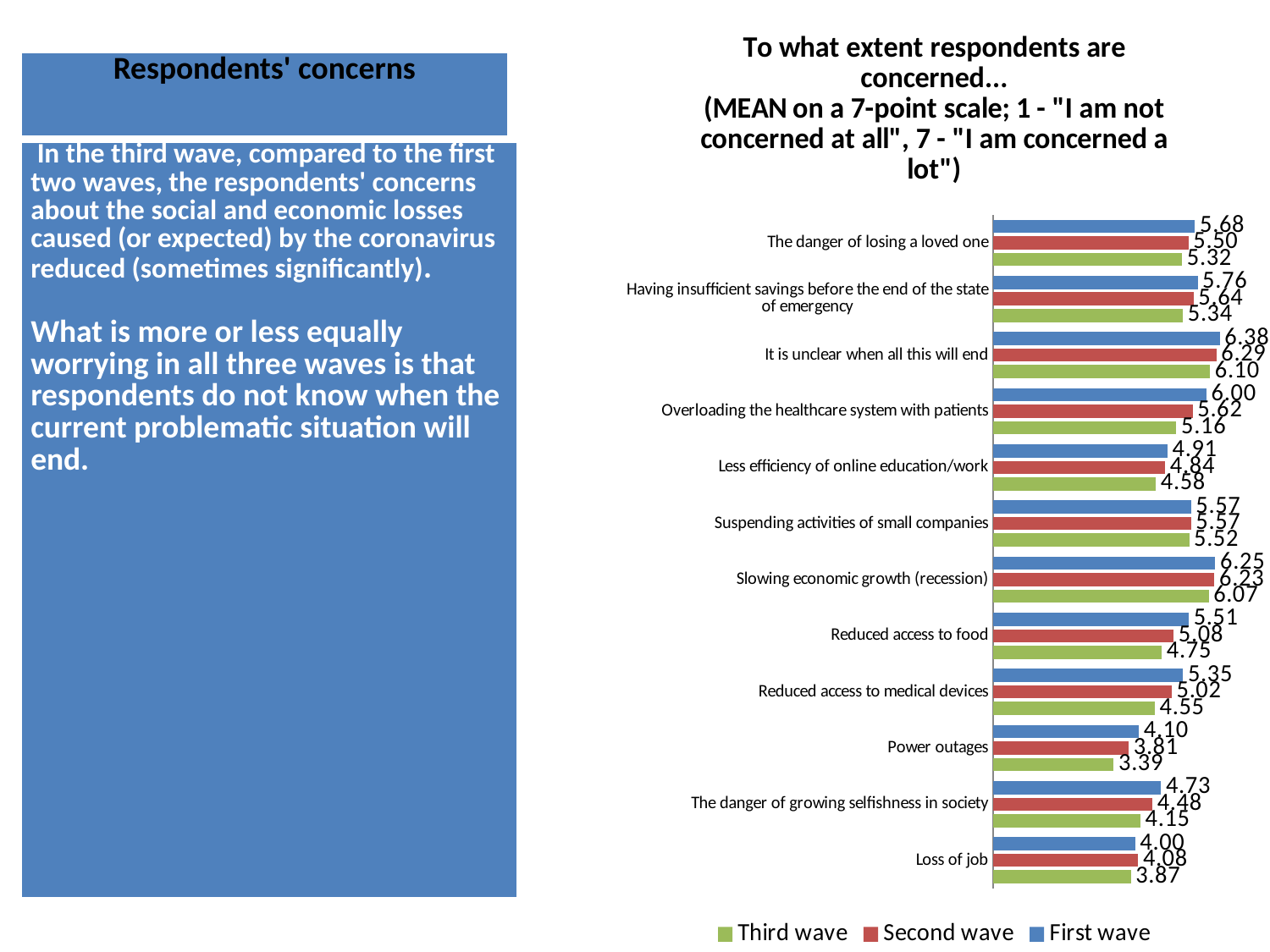
Which category has the lowest Third wave value? Power outages What type of chart is shown on the slide? bar chart What is the First wave value for 'It is unclear when all this will end'? 6.38 How many concern categories are plotted in the chart? 12 What is the Third wave value for 'Reduced access to medical devices'? 4.55 What is the Second wave value for 'Overloading the healthcare system with patients'? 5.62 Which is larger for 'Loss of job': the First wave value or the Second wave value? Second wave What is the difference between the First wave and Third wave values for 'Overloading the healthcare system with patients'? 0.84 Which category has the highest First wave value? It is unclear when all this will end Which series is shown in green in the legend? Third wave How many series does the legend list? 3 What is the Third wave value for 'Power outages'? 3.39